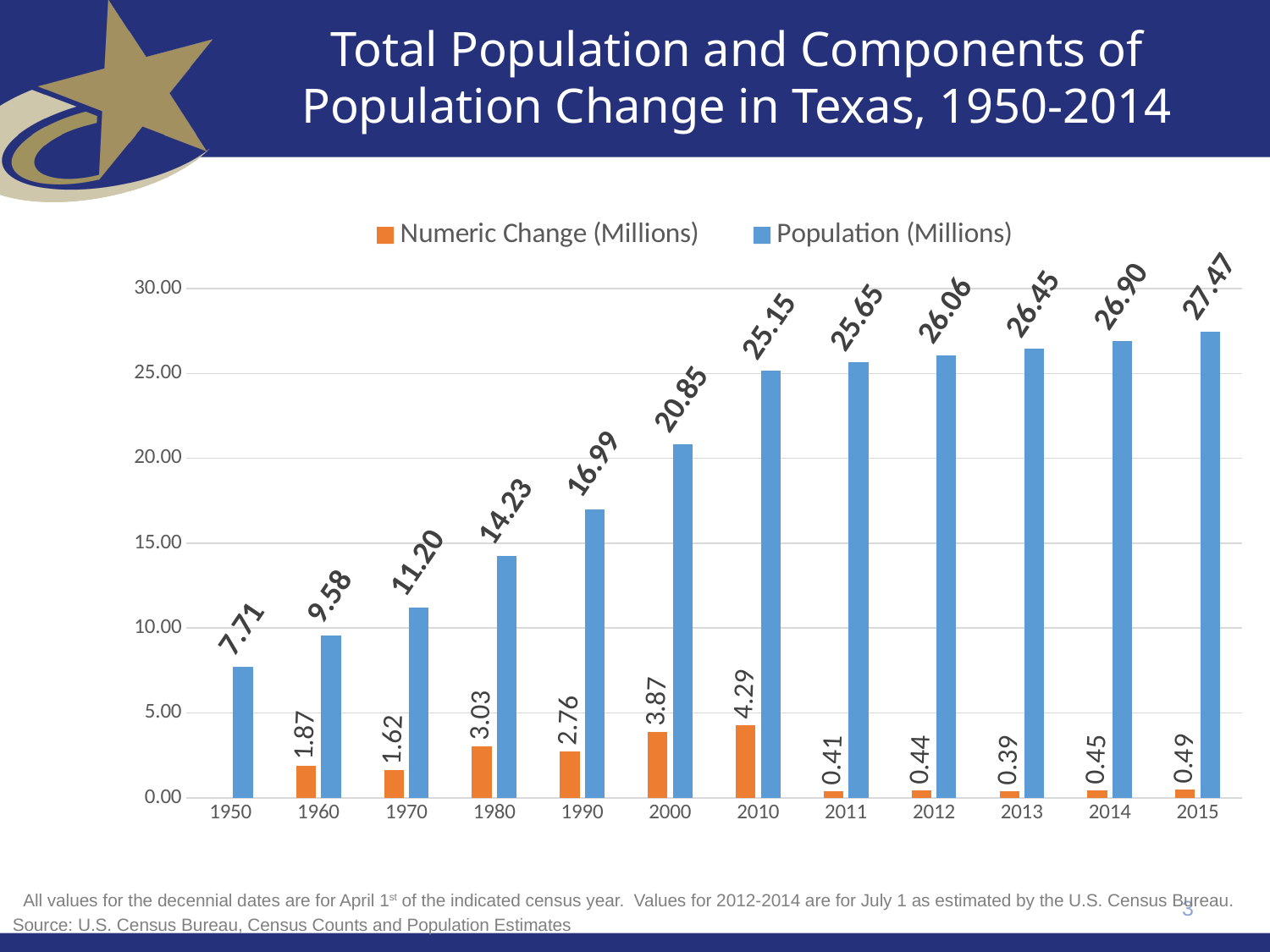
What colour are the Numeric Change (Millions) bars? orange Is the Population (Millions) value for 1990 greater or less than 15.00? greater What kind of chart is shown on the slide? bar chart How many series does the legend list? 2 Which year has the larger Numeric Change (Millions) value, 1980 or 1990? 1980 Which year has the lowest Numeric Change (Millions) value? 2013 What is the Numeric Change (Millions) value for 2010? 4.29 Which year has the highest Population (Millions) value? 2015 How many years are shown on the x axis of the chart? 12 What is the Population (Millions) value for 2000? 20.85 What is the difference between the Population (Millions) values for 2015 and 2010? 2.32 Does the Population (Millions) series rise or fall from 1950 to 2015? rise